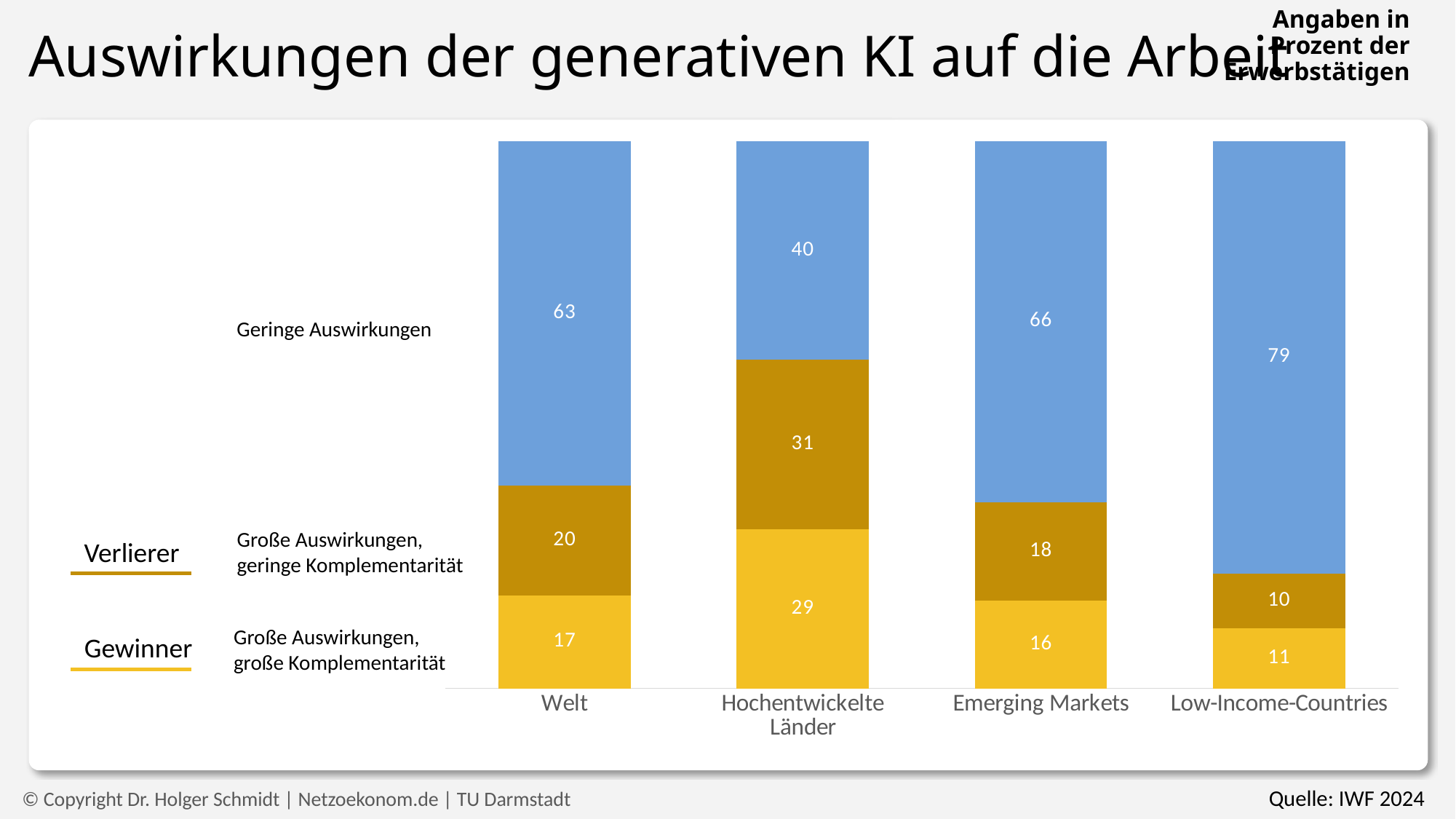
What kind of chart is shown on the slide? Stacked bar chart Which is larger: the 'Große Auswirkungen, große Komplementarität' value for Welt or for Emerging Markets? Welt What is the value for 'Geringe Auswirkungen' for Welt? 63 What is the value for 'Große Auswirkungen, große Komplementarität' for Low-Income-Countries? 11 Which category has the highest value for 'Geringe Auswirkungen'? Low-Income-Countries What is the total of the stacked bar for Hochentwickelte Länder? 100 Which category has the lowest value for 'Große Auswirkungen, große Komplementarität'? Low-Income-Countries What is the difference between the 'Geringe Auswirkungen' values for Low-Income-Countries and Hochentwickelte Länder? 39 How many categories are shown on the x axis of the chart? 4 What is the value for 'Große Auswirkungen, geringe Komplementarität' for Hochentwickelte Länder? 31 How many series are stacked in each bar of the chart? 3 Which series is labelled 'Gewinner' on the slide? Große Auswirkungen, große Komplementarität